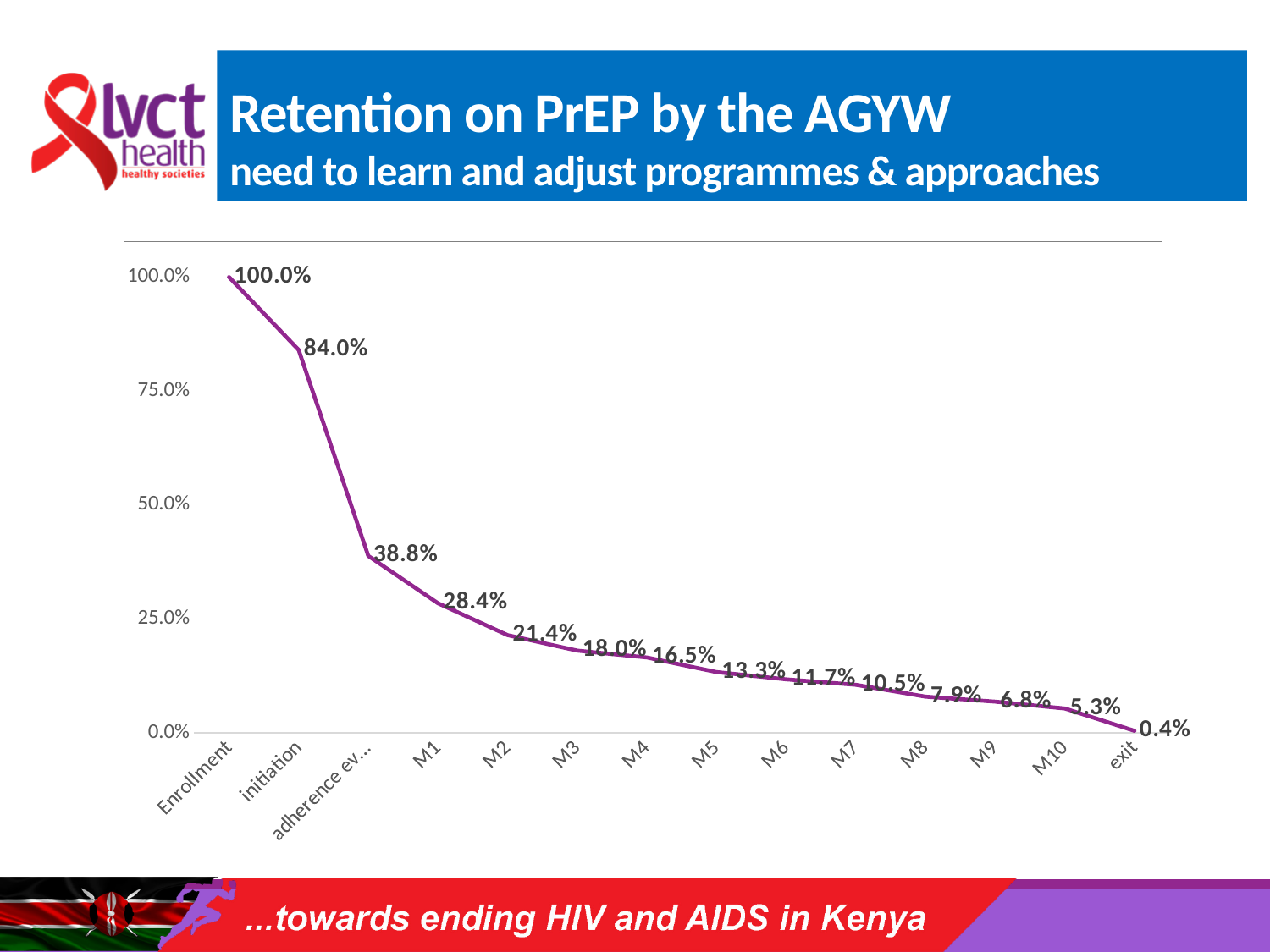
Which category has the highest value? Enrollment What is the value at M1? 28.4% What is the value at exit? 0.4% Do the values rise or fall along the x axis from Enrollment to exit? Fall What kind of chart is shown on the slide? Line chart What is the value at M5? 13.3% How many categories are plotted along the x axis? 14 What is the value at initiation? 84.0% What is the difference between the values at Enrollment and initiation? 16.0% Which category has the lowest value? exit Which is larger, the value at M2 or the value at M4? M2 What is the value at Enrollment? 100.0%